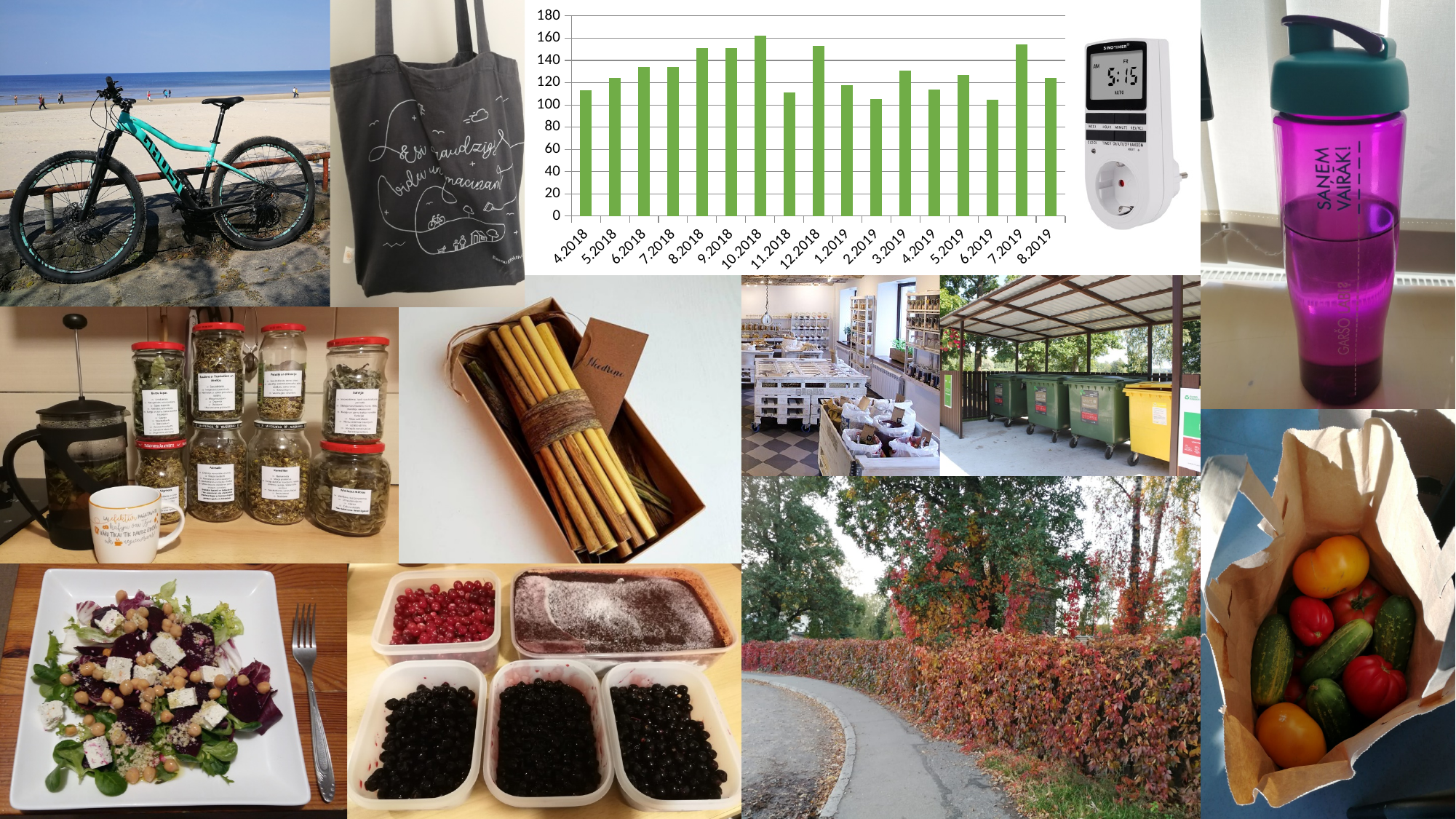
Is the value for 4.2018 greater or less than 100? greater What colour are the bars in the chart? green Which is larger, the value for 10.2018 or the value for 11.2018? 10.2018 Is the value for 11.2018 greater or less than 120? less Is the value for 2.2019 greater or less than 120? less What kind of chart is shown on the slide? bar chart Which month has the highest bar in the chart? 10.2018 Do the values rise or fall from 4.2018 to 10.2018? rise Which is larger, the value for 7.2019 or the value for 6.2019? 7.2019 How many bars (months) does the chart show? 17